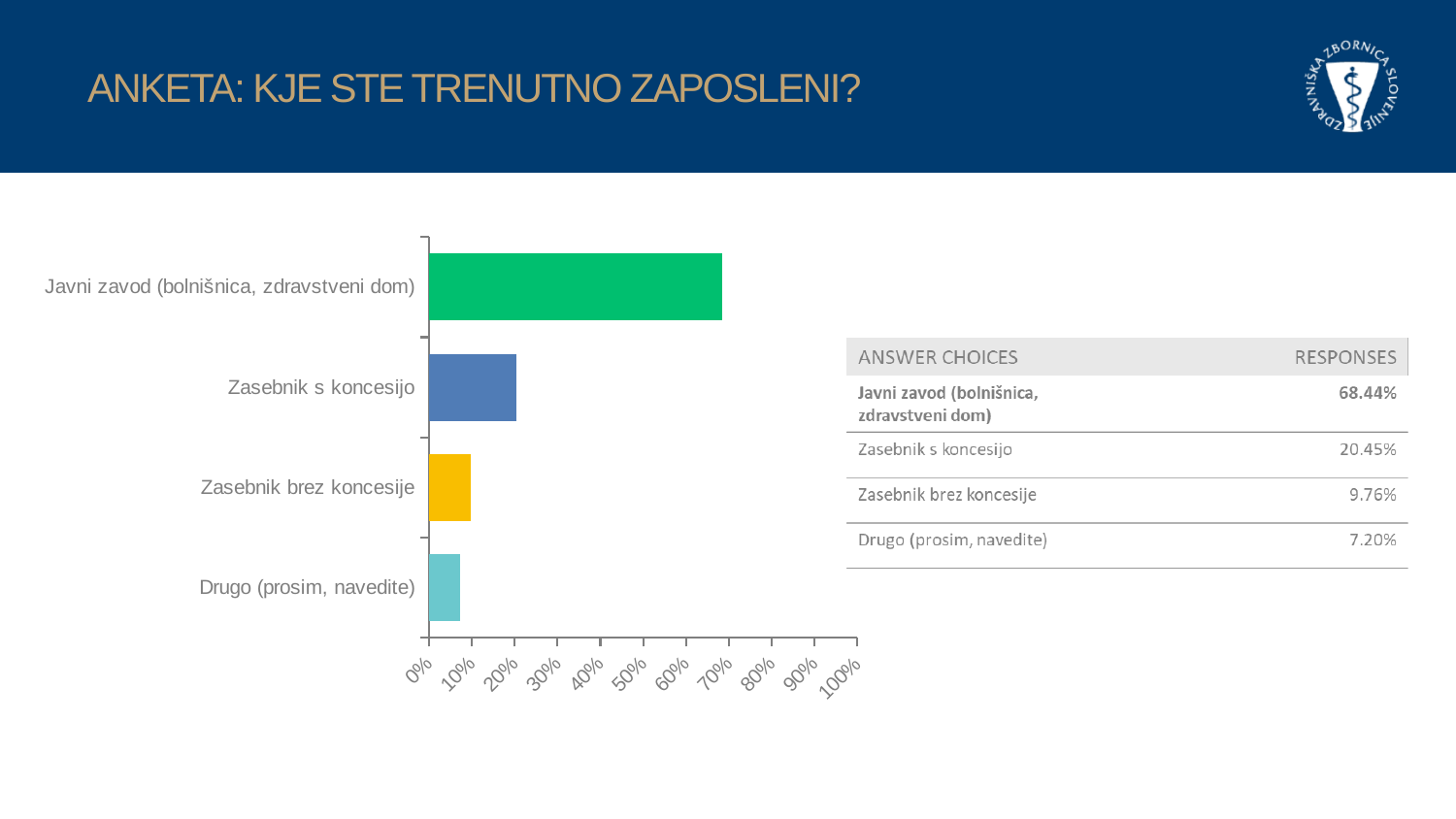
What kind of chart is shown on the slide? bar chart Which has a larger response share, "Zasebnik brez koncesije" or "Drugo (prosim, navedite)"? Zasebnik brez koncesije What is the response share for "Zasebnik brez koncesije"? 9.76% Which category has the lowest response share? Drugo (prosim, navedite) What is the response share for "Javni zavod (bolnišnica, zdravstveni dom)"? 68.44% What colour is the bar for "Javni zavod (bolnišnica, zdravstveni dom)"? green What is the response share for "Drugo (prosim, navedite)"? 7.20% What is the difference in response share between "Javni zavod (bolnišnica, zdravstveni dom)" and "Zasebnik s koncesijo"? 47.99% What is the response share for "Zasebnik s koncesijo"? 20.45% Which category has the highest response share? Javni zavod (bolnišnica, zdravstveni dom) Is the value for "Zasebnik s koncesijo" greater or less than 30%? less How many categories does the bar chart show? 4